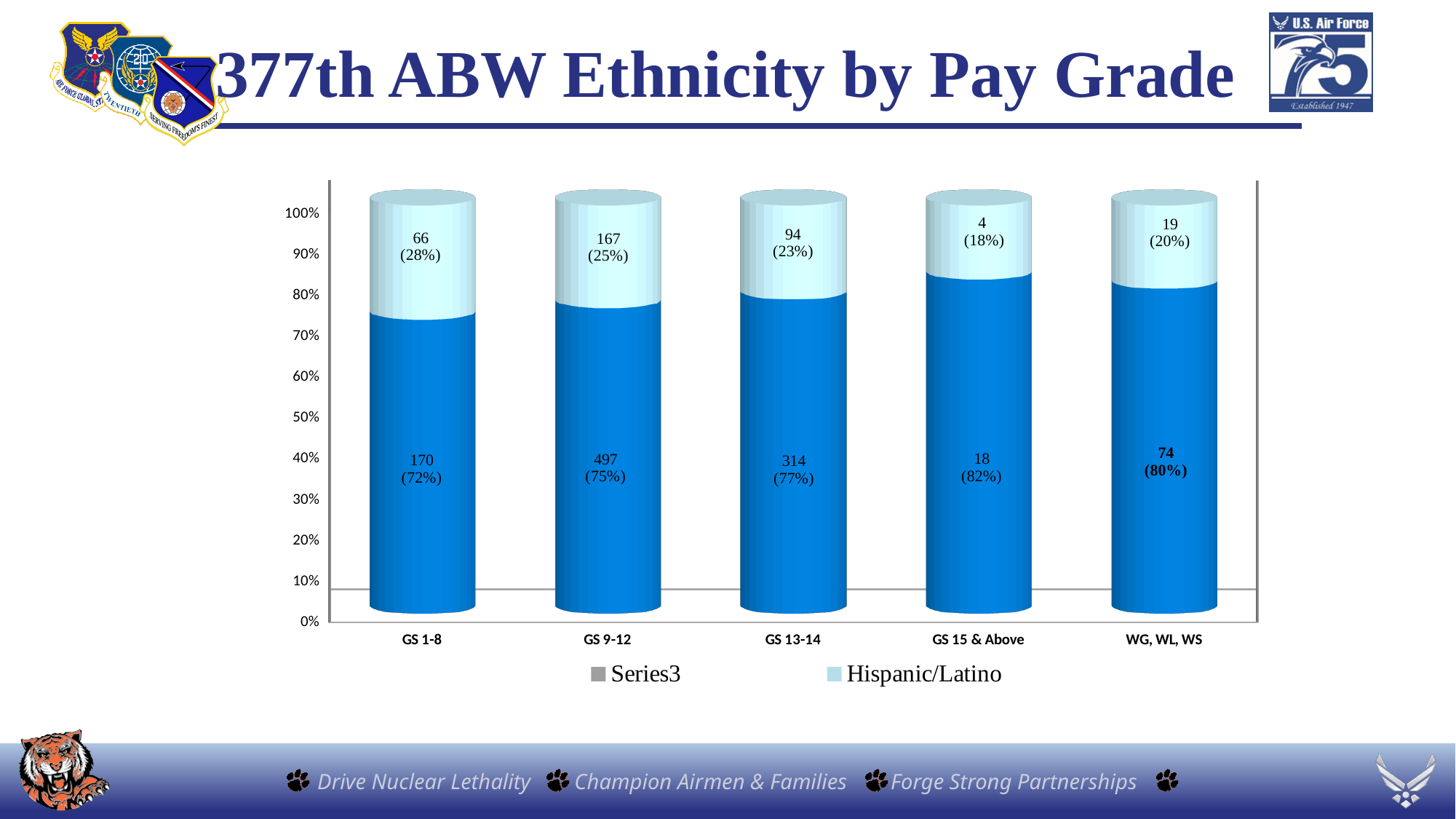
Which pay grade has the lowest Hispanic/Latino percentage? GS 15 & Above What is the difference between the Series3 counts for GS 9-12 and GS 1-8? 327 What is the total count (Series3 plus Hispanic/Latino) for the GS 1-8 bar? 236 Which has a larger Hispanic/Latino count, GS 13-14 or WG, WL, WS? GS 13-14 What kind of chart is shown on the slide? Stacked bar chart What is the Hispanic/Latino count shown for the GS 9-12 pay grade? 167 How many pay grade categories are shown on the x axis? 5 Is the Series3 share of the GS 15 & Above bar greater or less than 80%? greater Which pay grade has the highest Hispanic/Latino percentage? GS 1-8 How many series does the legend list? 2 What is the Hispanic/Latino count and percentage shown for WG, WL, WS? 19 (20%) What percentage is shown for the Series3 segment of the GS 13-14 bar? 77%